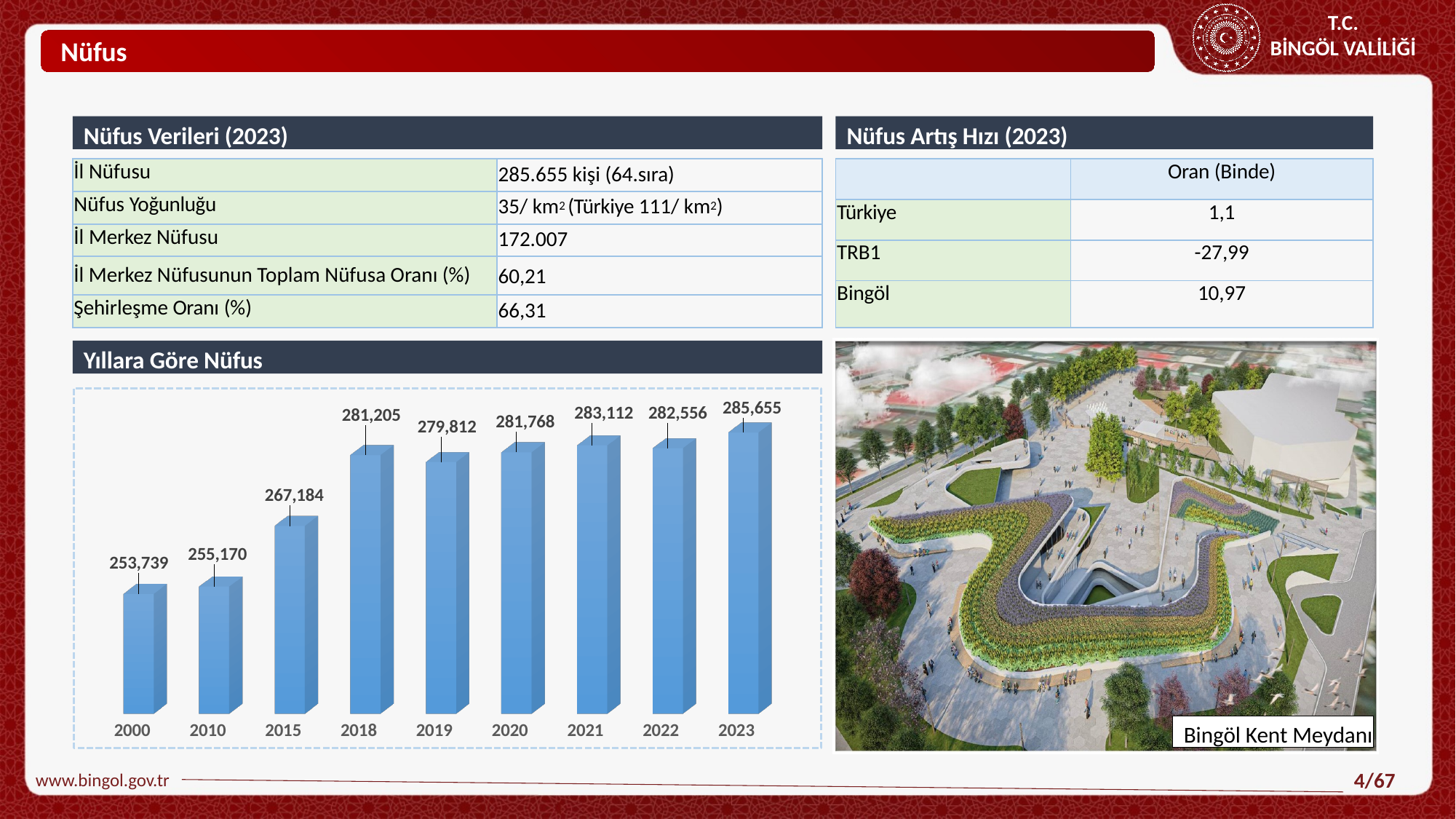
Which year has the highest population in the Yıllara Göre Nüfus chart? 2023 What is the population value shown for 2015 in the Yıllara Göre Nüfus chart? 267,184 Does the population in the Yıllara Göre Nüfus chart generally rise or fall from 2000 to 2023? Rise What is the population value shown for 2022 in the Yıllara Göre Nüfus chart? 282,556 What is the population value shown for 2000 in the Yıllara Göre Nüfus chart? 253,739 In the Yıllara Göre Nüfus chart, which is larger: the value for 2021 or the value for 2022? 2021 How many years are shown in the Yıllara Göre Nüfus chart? 9 What is the difference between the 2018 and 2019 population values in the Yıllara Göre Nüfus chart? 1,393 What is the population value shown for 2019 in the Yıllara Göre Nüfus chart? 279,812 Which year has the lowest population in the Yıllara Göre Nüfus chart? 2000 What kind of chart is the Yıllara Göre Nüfus chart? Bar chart What is the difference between the 2023 and 2000 population values in the Yıllara Göre Nüfus chart? 31,916